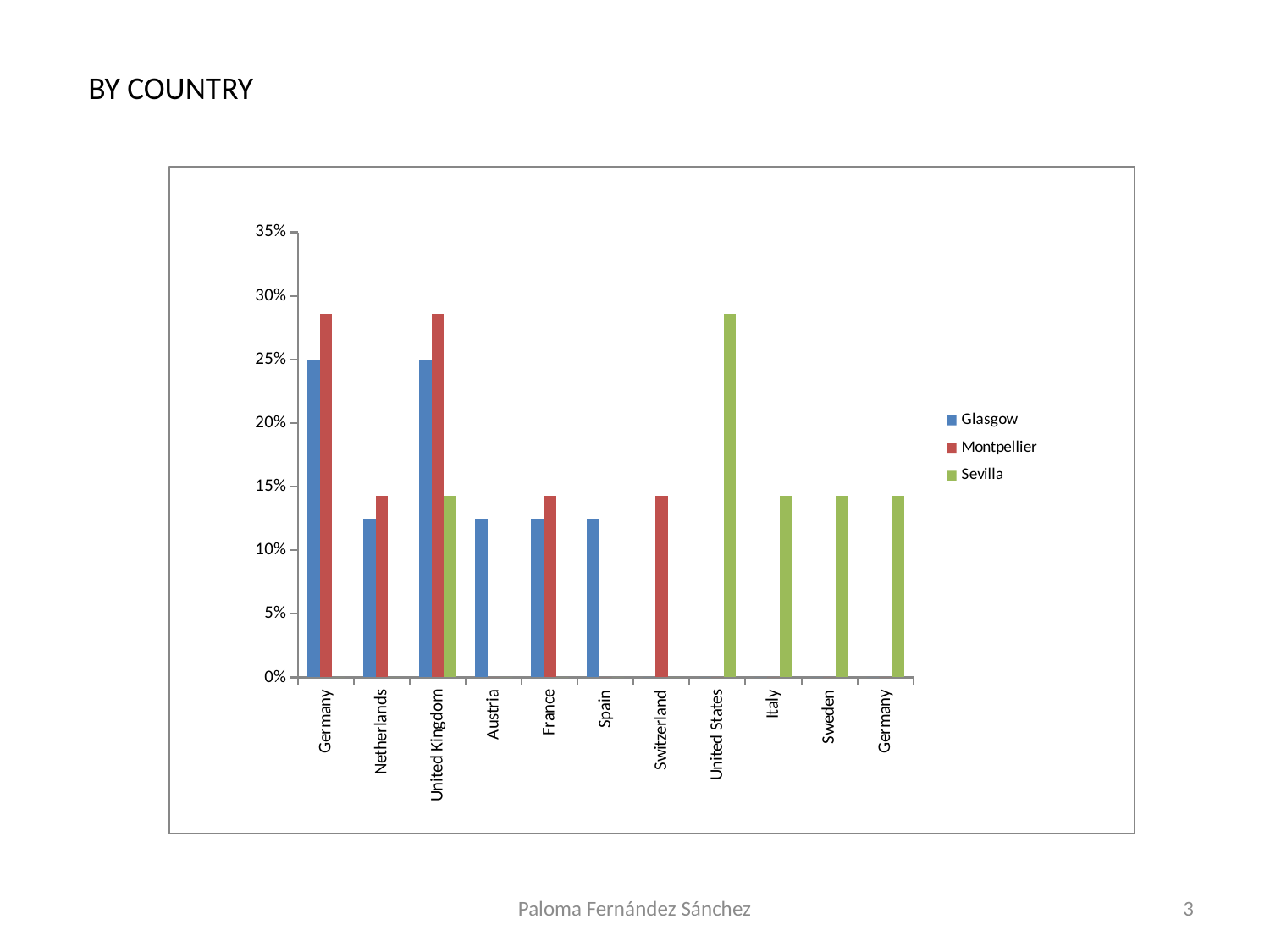
How many country categories are shown on the x axis? 11 Is the Glasgow value for Netherlands greater or less than 15%? less How many series does the legend list? 3 What is the title of the slide? BY COUNTRY Is the Montpellier value for Germany (first category) greater or less than 25%? greater What kind of chart is shown on the slide? bar chart Which category has the highest Glasgow value, Austria or Germany (first category)? Germany Is the Sevilla value for United States greater or less than 25%? greater Which is larger for Netherlands: the Glasgow value or the Montpellier value? Montpellier Which is larger for United Kingdom: the Glasgow value or the Sevilla value? Glasgow Which series has a bar for United States? Sevilla